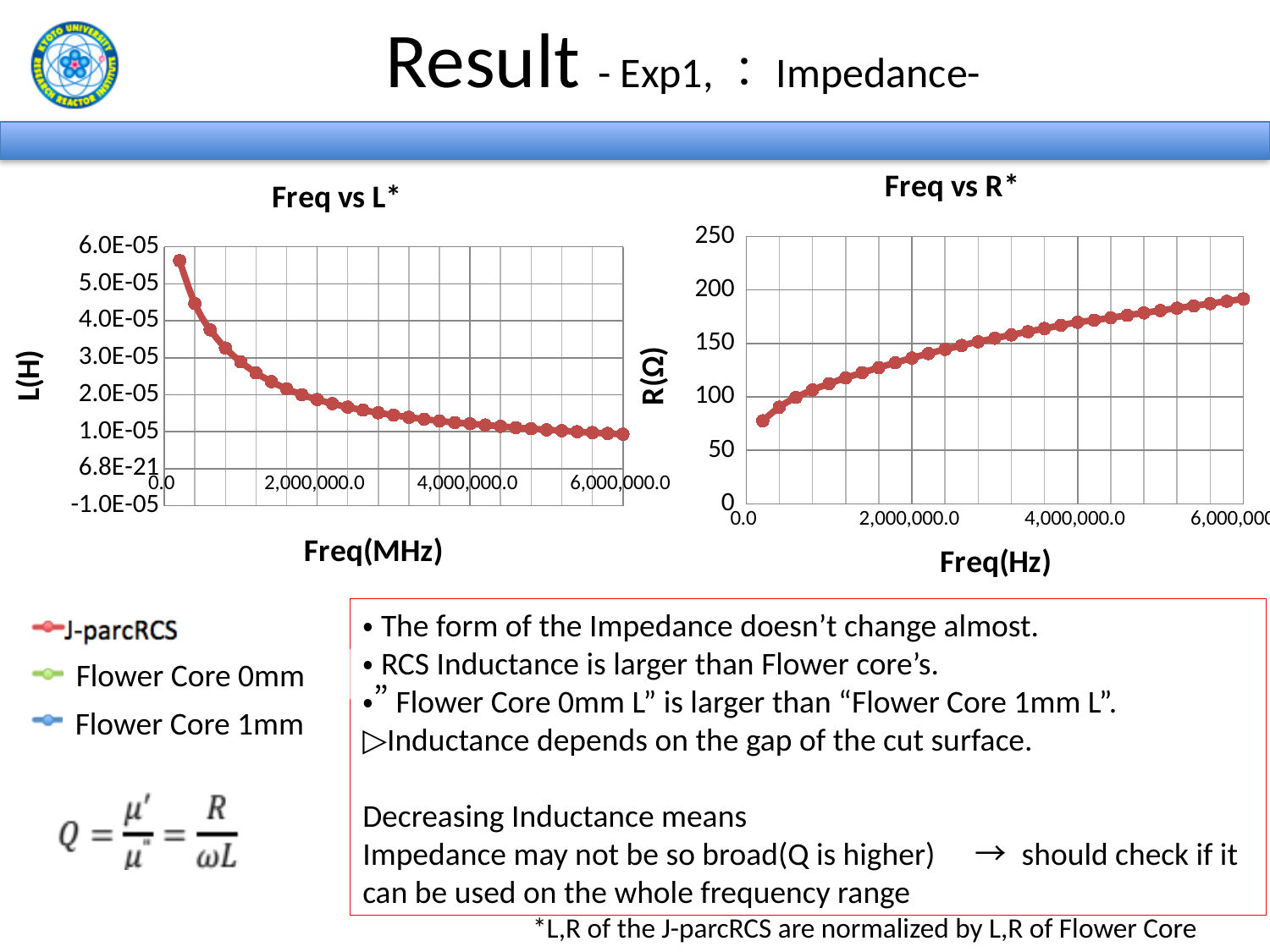
In the "Freq vs R*" chart, is the value of the first (lowest-frequency) point greater or less than 100? less In the "Freq vs L*" chart, do the values rise or fall as frequency increases? fall In the "Freq vs R*" chart, is the value at 6,000,000.0 greater or less than 150? greater What kind of chart is the "Freq vs L*" chart? line chart In the "Freq vs R*" chart, is the value larger at 2,000,000.0 or at 4,000,000.0? 4,000,000.0 In the "Freq vs R*" chart, is the value at 2,000,000.0 greater or less than 100? greater What is the y-axis label of the "Freq vs L*" chart? L(H) What is the title of the chart on the right of the slide? Freq vs R* In the "Freq vs R*" chart, do the values rise or fall as frequency increases? rise